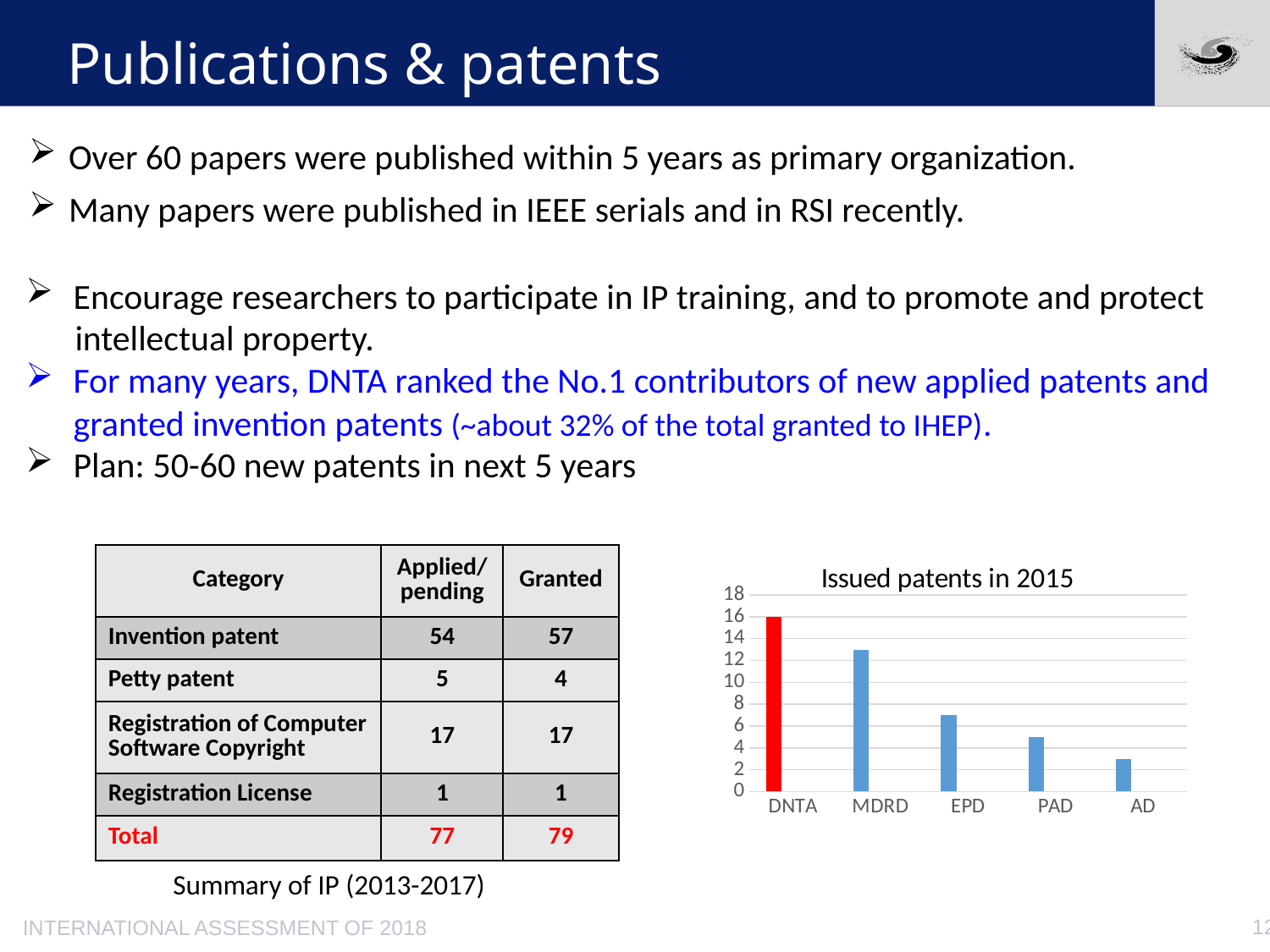
Which category has the highest value in the chart? DNTA What is the title of the chart on the slide? Issued patents in 2015 Is the value for EPD greater or less than 8? less Is the value for MDRD greater or less than 12? greater Which bar in the chart is coloured red rather than blue? DNTA What kind of chart is shown on the slide? bar chart Is the value for AD greater or less than 4? less Which category has the lowest value in the chart? AD What is the value for DNTA in the chart? 16 Which has a larger value, MDRD or PAD? MDRD How many categories are shown on the x axis of the chart? 5 Do the values rise or fall moving from DNTA to AD along the x axis? fall